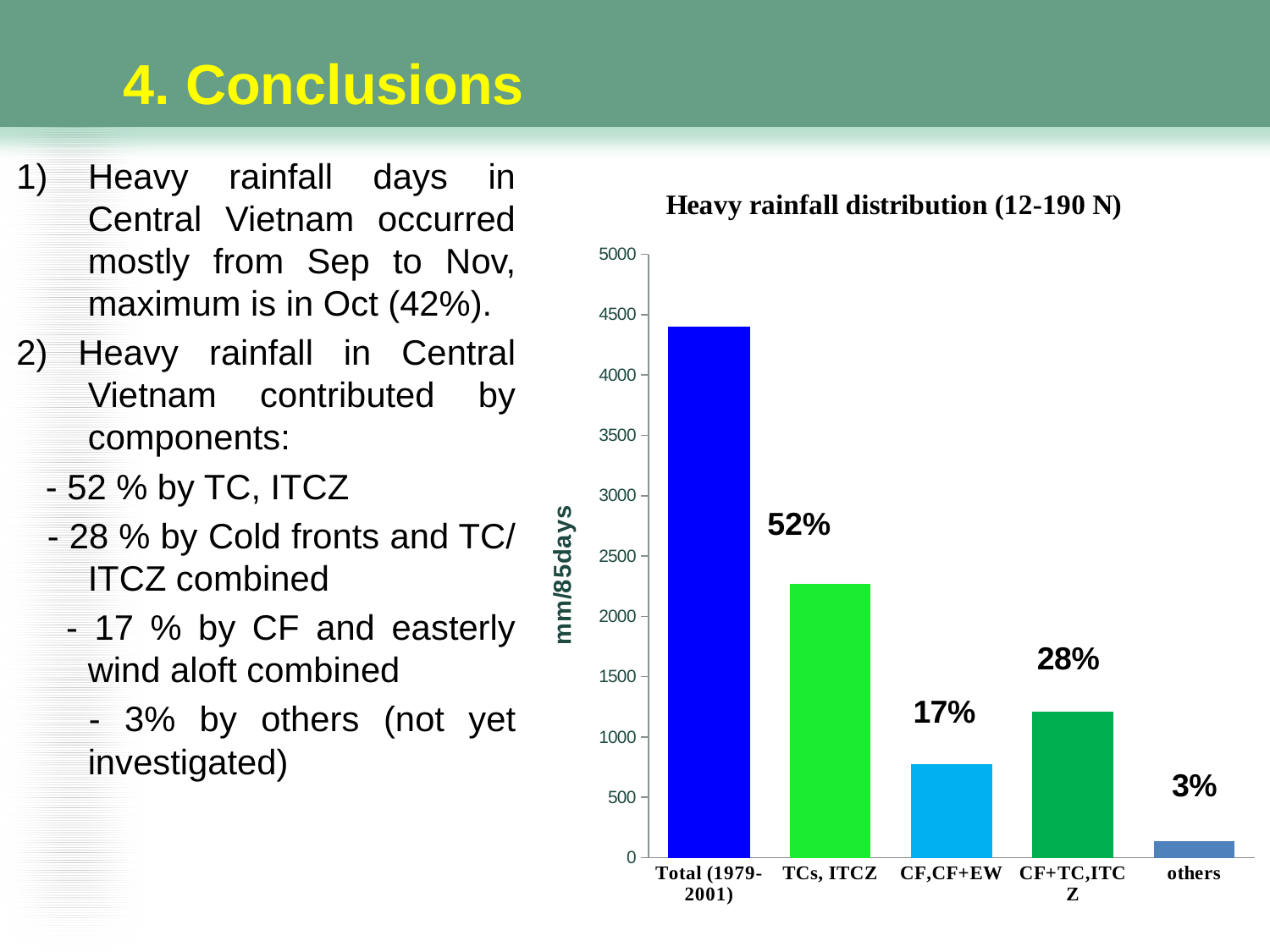
Which bar is taller, CF+TC,ITCZ or CF,CF+EW? CF+TC,ITCZ Which category has the shortest bar in the chart? others What kind of chart is shown on the slide? bar chart What percentage label is shown for the CF,CF+EW bar? 17% Is the value for Total (1979-2001) greater or less than 4000? greater What percentage label is shown for the TCs, ITCZ bar? 52% Which category has the tallest bar in the chart? Total (1979-2001) What is the label on the vertical axis of the chart? mm/85days What is the title of the chart? Heavy rainfall distribution (12-190 N) What percentage label is shown for the CF+TC,ITCZ bar? 28% How many categories are shown on the x axis of the chart? 5 What percentage label is shown for the others bar? 3%